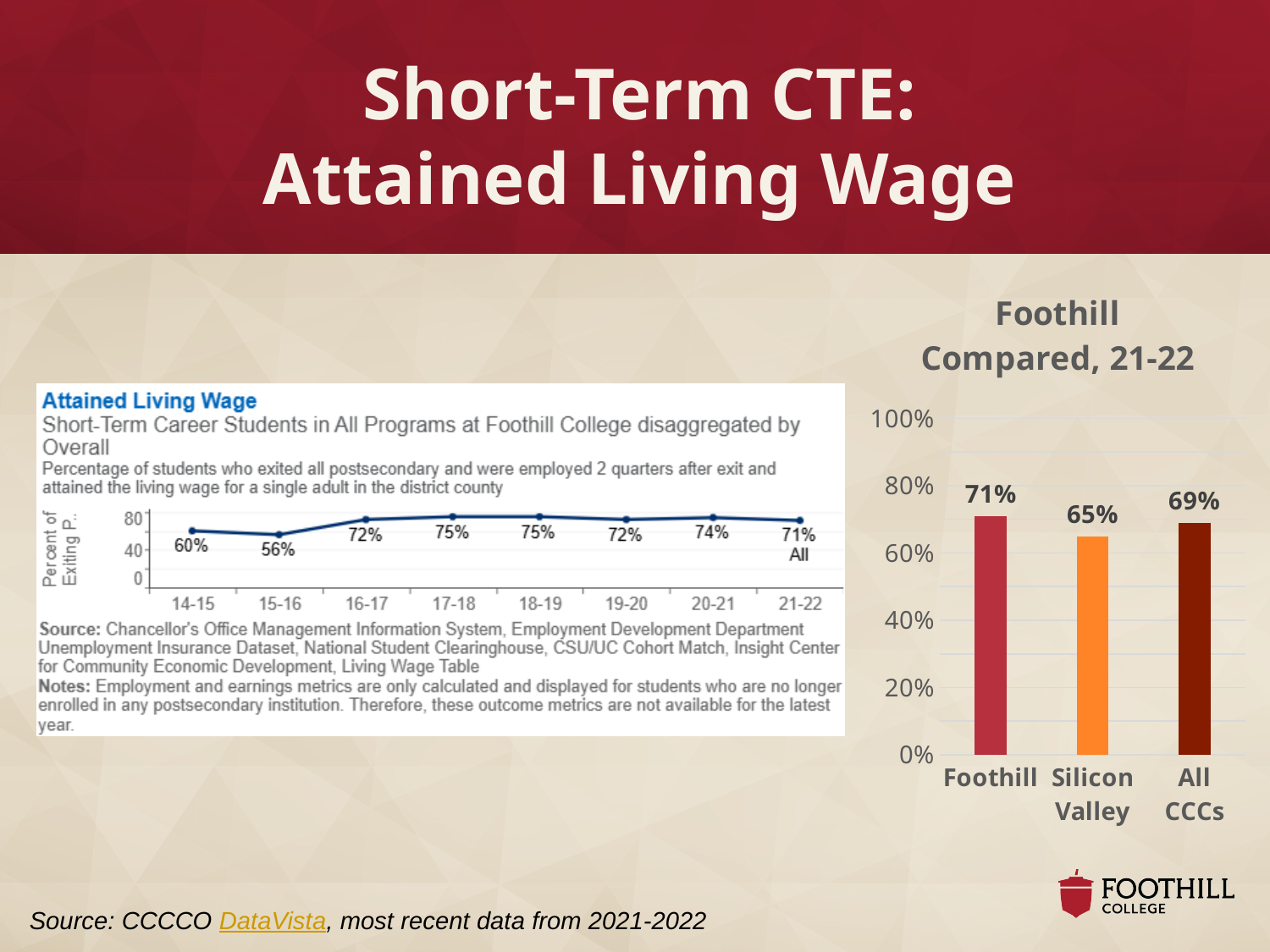
In the 'Foothill Compared, 21-22' bar chart, what is the value for All CCCs? 69% In the 'Attained Living Wage' line chart, what is the value for 15-16? 56% In the 'Foothill Compared, 21-22' bar chart, what is the difference between the Foothill value and the Silicon Valley value? 6% In the 'Attained Living Wage' line chart, how many years are plotted? 8 In the 'Attained Living Wage' line chart, which year has the lowest value? 15-16 In the 'Foothill Compared, 21-22' bar chart, which category has the highest value? Foothill In the 'Attained Living Wage' line chart, what is the value for 21-22? 71% What kind of chart is the 'Foothill Compared, 21-22' chart? Bar chart In the 'Attained Living Wage' line chart, is the value for 20-21 larger or smaller than the value for 19-20? Larger In the 'Foothill Compared, 21-22' bar chart, what is the value for Silicon Valley? 65% In the 'Foothill Compared, 21-22' bar chart, which category has the lowest value? Silicon Valley In the 'Foothill Compared, 21-22' bar chart, how many categories are shown? 3